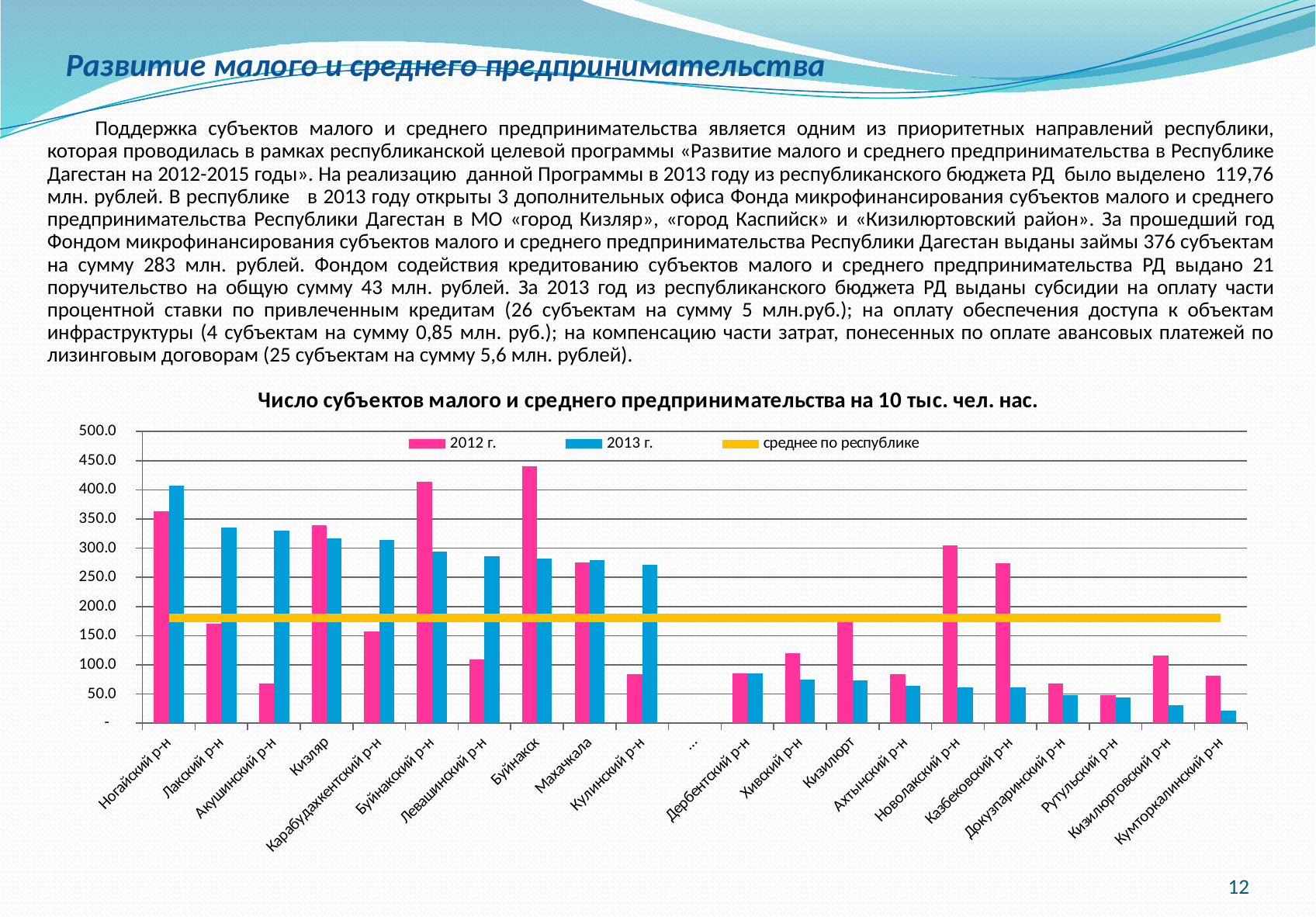
For Лакский р-н, which is larger: the 2012 г. value or the 2013 г. value? 2013 г. Is the 2012 г. value for Буйнакск greater or less than 400? greater Which category has the highest 2012 г. value? Буйнакск Is the 2012 г. value for Кизляр greater or less than 300? greater For Буйнакск, which is larger: the 2012 г. value or the 2013 г. value? 2012 г. For Ногайский р-н, which is larger: the 2012 г. value or the 2013 г. value? 2013 г. Is the 2013 г. value for Кумторкалинский р-н greater or less than 50? less What kind of chart is shown on the slide? bar chart How many series does the chart legend list? 3 Which category has the highest 2013 г. value? Ногайский р-н What is the title of the chart? Число субъектов малого и среднего предпринимательства на 10 тыс. чел. нас.